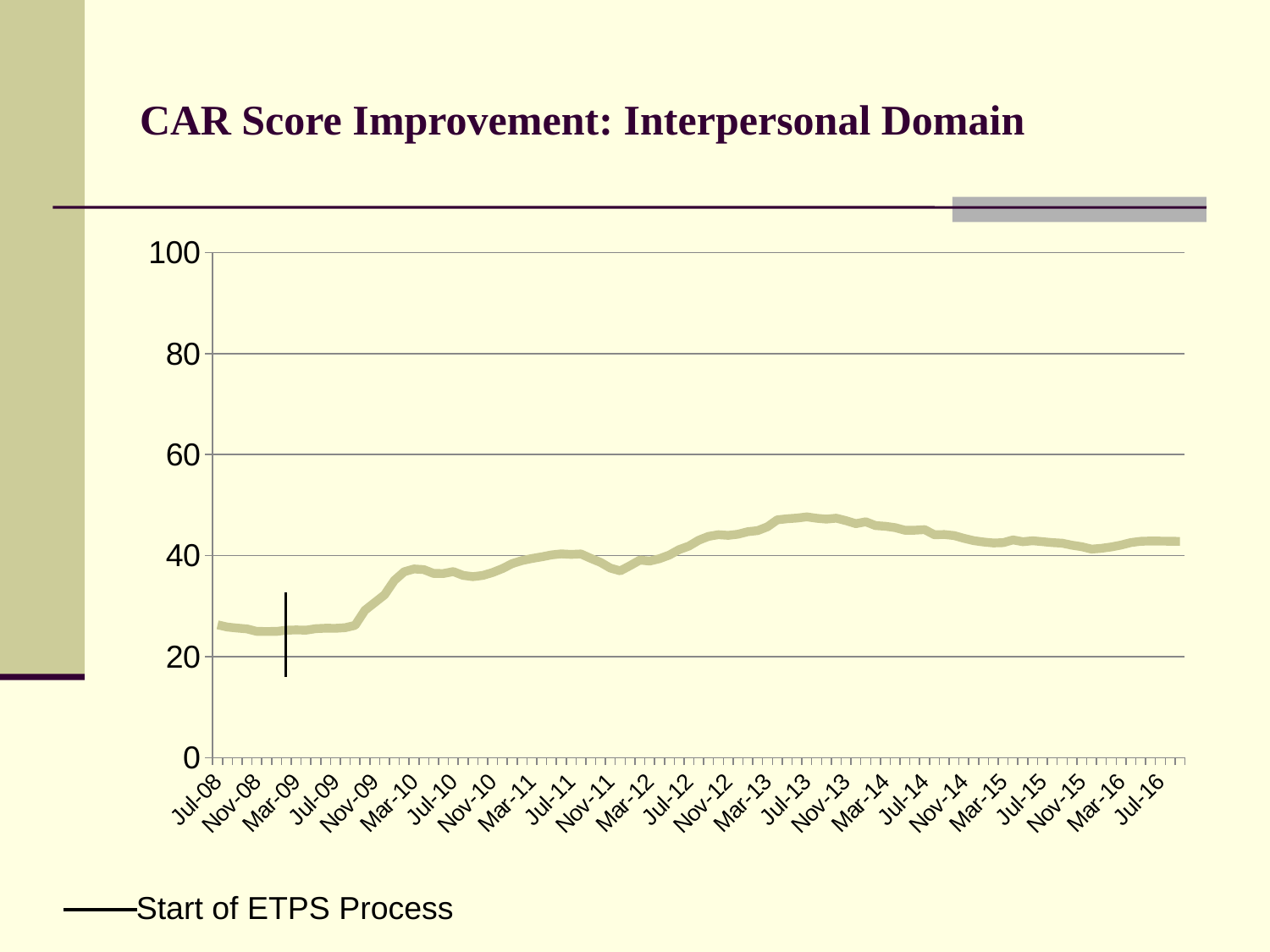
Which is larger, the value for Jul-13 or the value for Jul-16? Jul-13 What is the title of the chart? CAR Score Improvement: Interpersonal Domain Is the value for Jul-08 greater or less than 20? greater Do the values generally rise or fall from Jul-08 to Jul-13? rise Is the value for Jul-13 greater or less than 60? less Is the value for Mar-09 greater or less than 40? less What kind of chart is shown on the slide? line chart How many entries does the chart's legend list? 1 What does the vertical black line on the chart mark, according to the legend? Start of ETPS Process Which is larger, the value for Jul-08 or the value for Jul-13? Jul-13